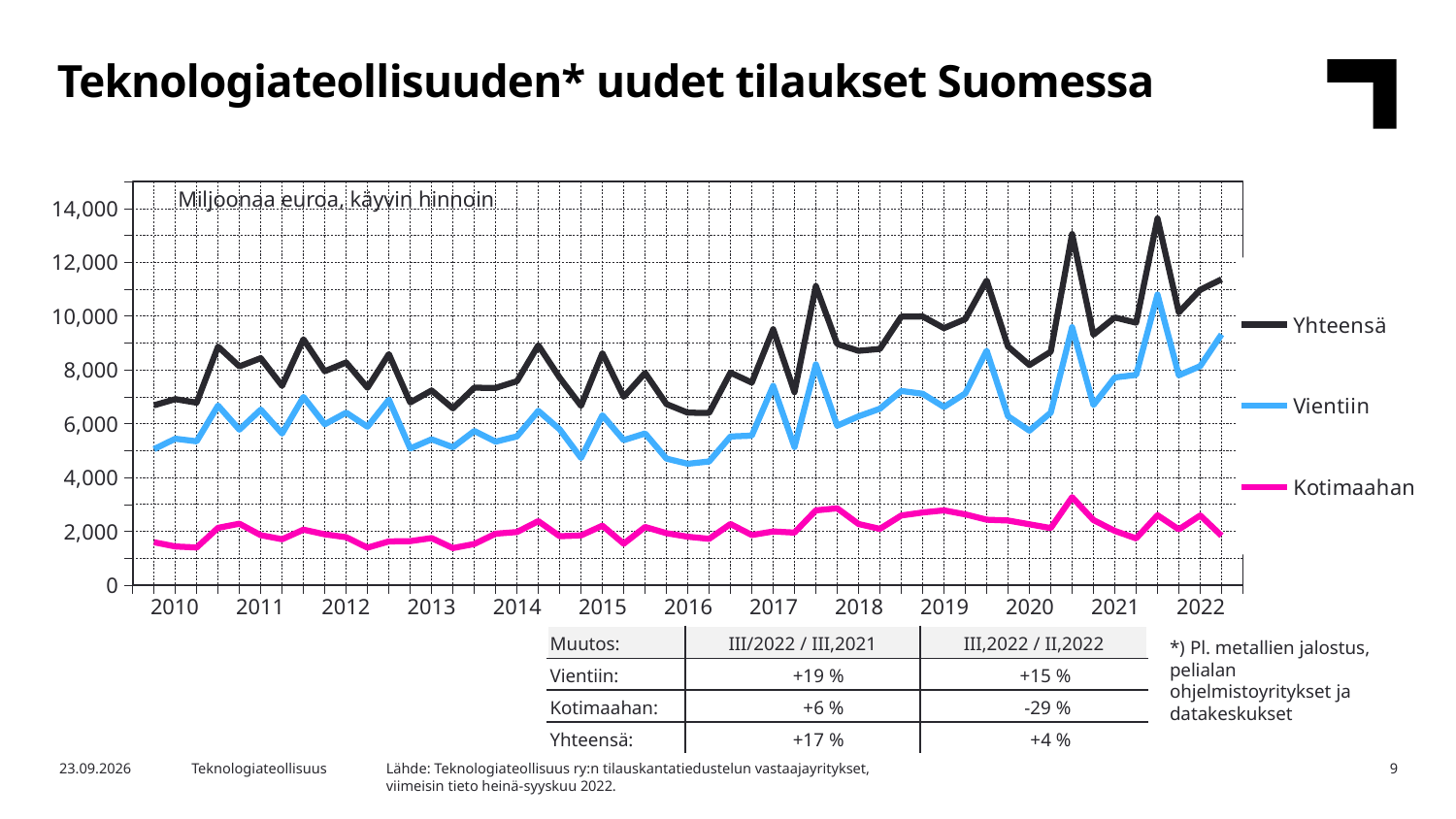
How many series does the chart legend list? 3 Is the first value of the Vientiin line in 2010 greater or less than 6,000? less Is the highest value reached by the Kotimaahan line greater or less than 4,000? less Does the Yhteensä line overall rise or fall from 2010 to 2022? rise Is the peak of the Vientiin line in 2021 greater or less than 10,000? greater Which series has the highest values across the whole chart? Yhteensä What unit label is printed inside the chart area? Miljoonaa euroa, käyvin hinnoin What are the three series named in the chart legend? Yhteensä, Vientiin, Kotimaahan What type of chart is shown on the slide? line chart Which series has the lowest values across the whole chart? Kotimaahan How many year labels are shown on the x axis? 13